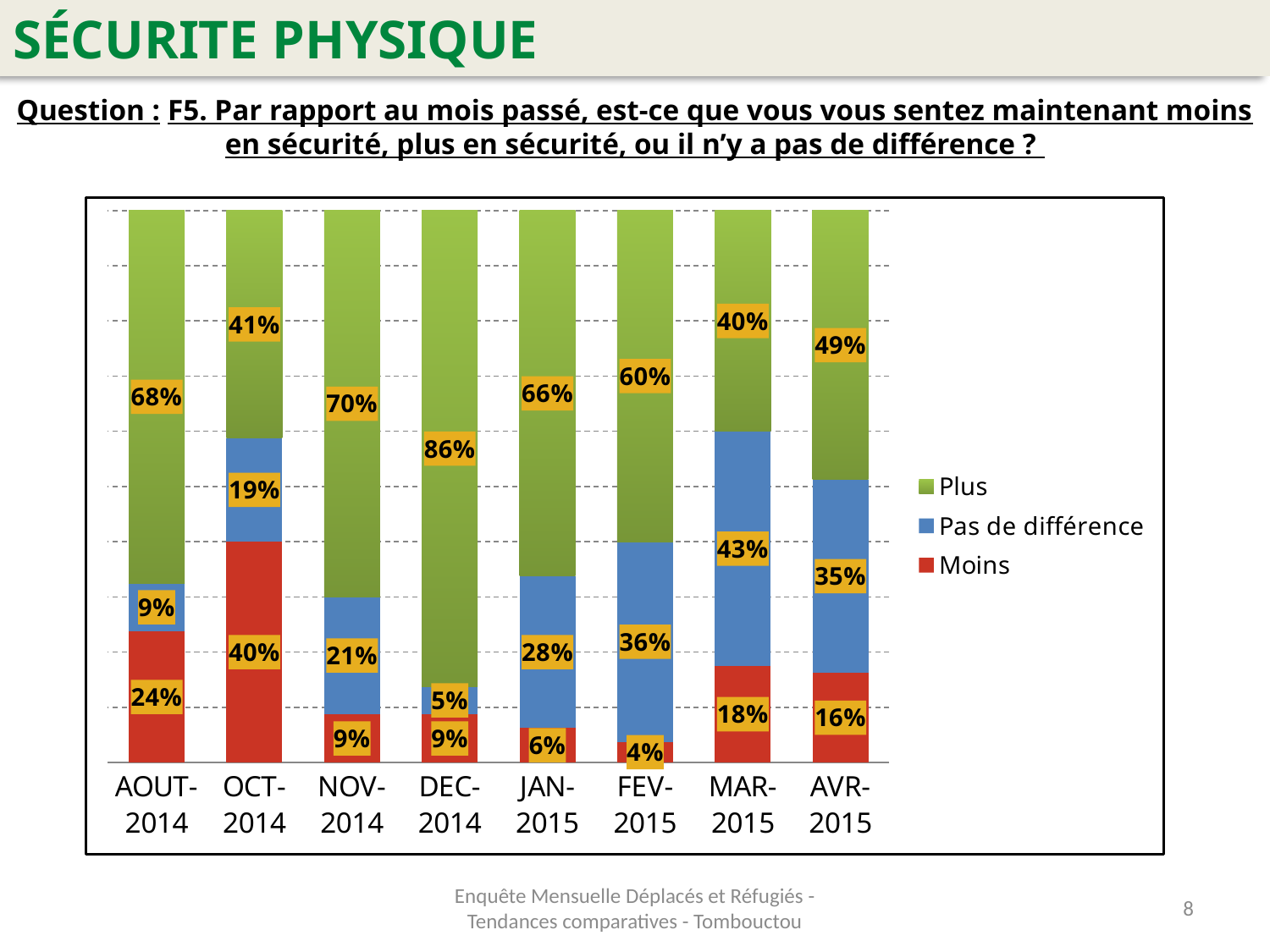
How many months are shown on the x axis? 8 What is the value of 'Moins' for OCT-2014? 40% Which is larger, the 'Moins' value for AOUT-2014 or for AVR-2015? AOUT-2014 In which month is the 'Plus' value highest? DEC-2014 What is the value of 'Plus' for DEC-2014? 86% What is the difference between the 'Plus' values for DEC-2014 and MAR-2015? 46% How many series does the legend list? 3 In which month is the 'Moins' value lowest? FEV-2015 Does the 'Pas de différence' value rise or fall from DEC-2014 to MAR-2015? rise What kind of chart is shown on the slide? stacked bar chart What is the value of 'Pas de différence' for MAR-2015? 43% Which legend entry is shown in red? Moins